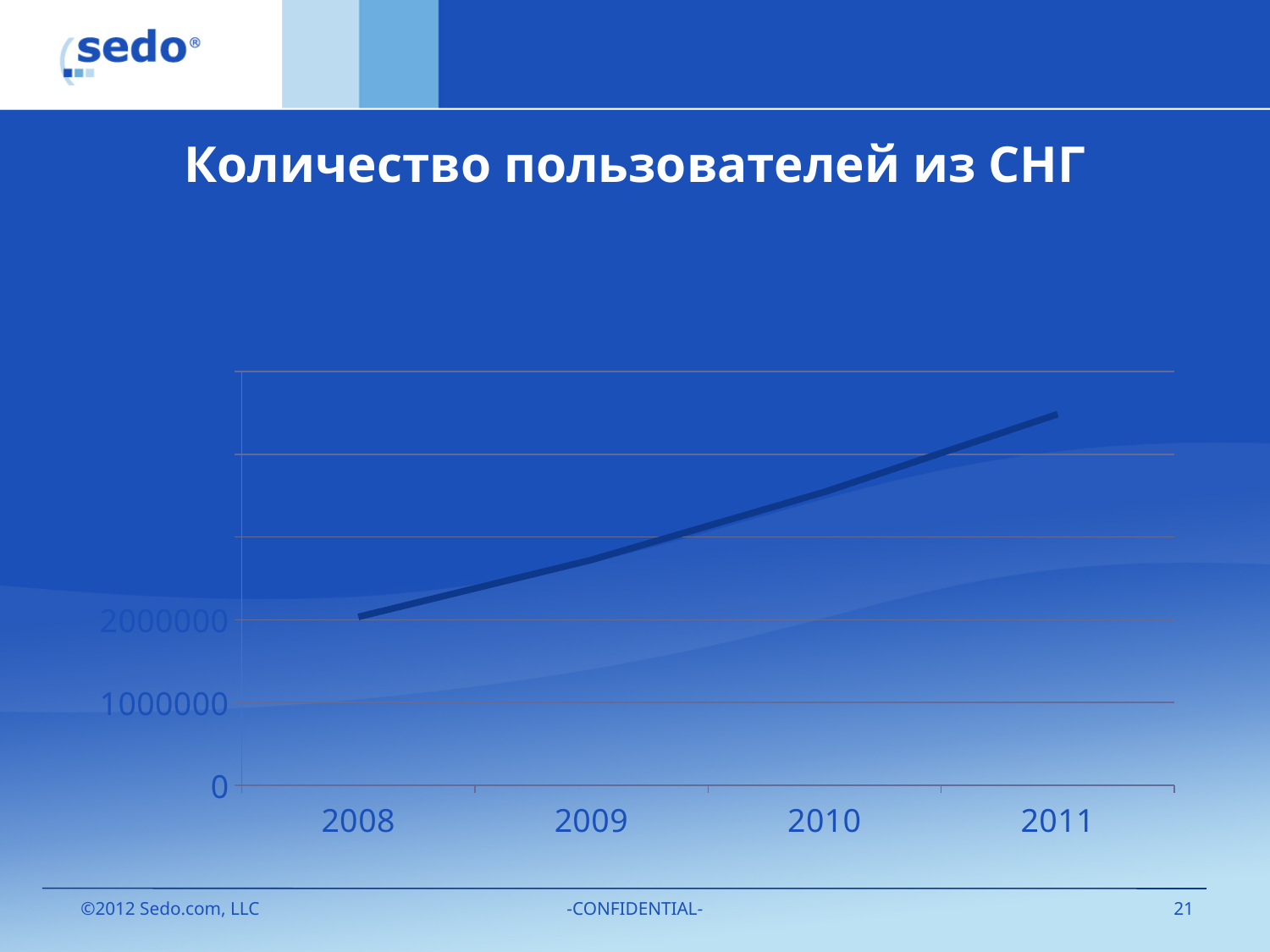
What is the title of the chart? Количество пользователей из СНГ What kind of chart is shown on the slide? line chart Do the values rise or fall from 2008 to 2011? rise Is the value for 2010 greater or less than 2000000? greater Is the value for 2011 greater or less than 2000000? greater Which is larger, the value for 2011 or the value for 2008? 2011 Which year has the lowest number of users? 2008 Is the value for 2008 greater or less than 1000000? greater What is the lowest value labelled on the y axis? 0 Which year has the highest number of users? 2011 How many years are plotted on the x axis? 4 Which is larger, the value for 2009 or the value for 2010? 2010